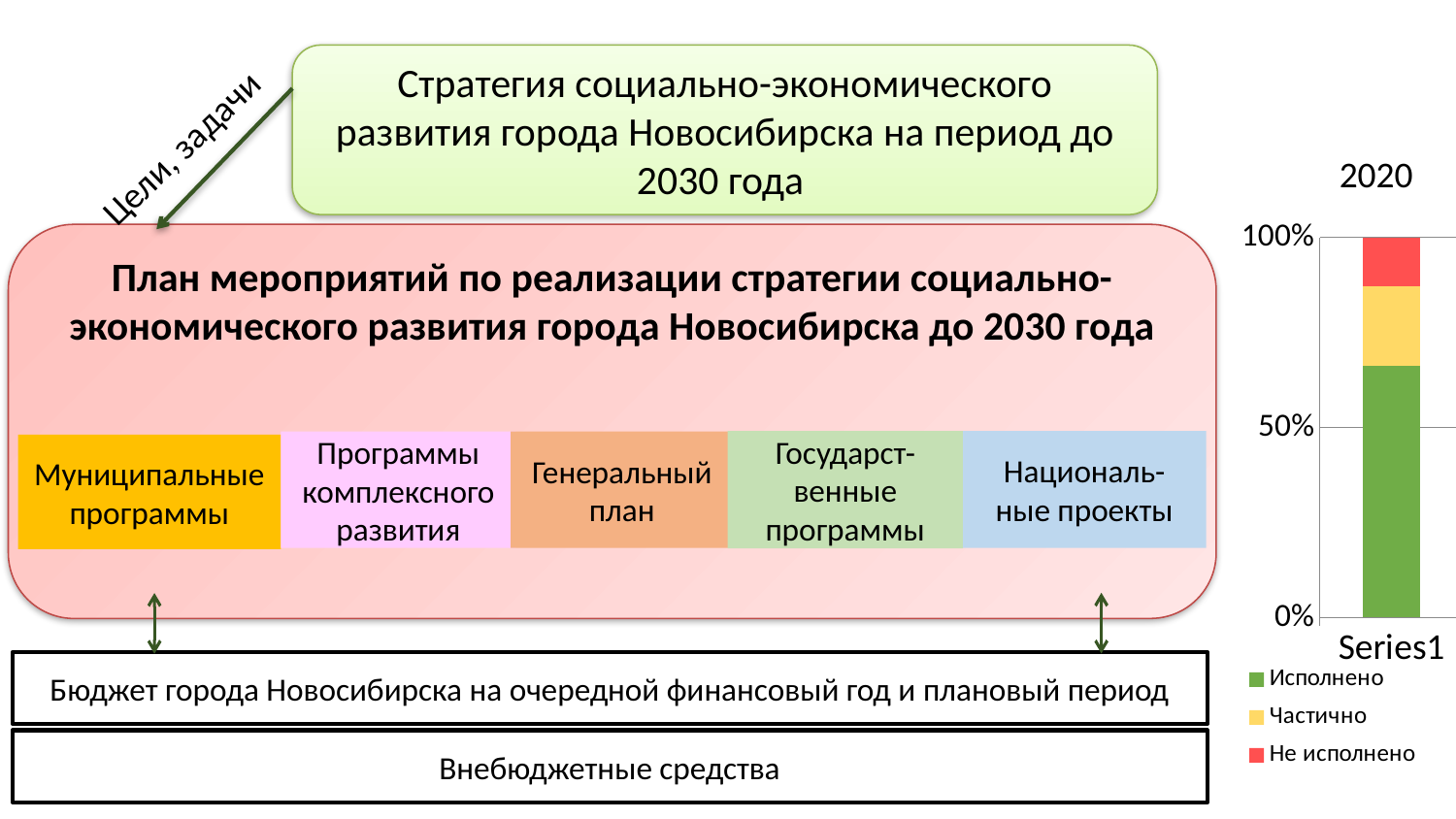
Is the value for Не исполнено in the chart greater or less than 50%? less Which series occupies the largest portion of the stacked bar in the chart? Исполнено What is the title of the chart on the right side of the slide? 2020 What is the highest value shown on the y axis of the chart? 100% Is the value for Исполнено in the chart greater or less than 50%? greater Which series occupies the smallest portion of the stacked bar in the chart? Не исполнено Which is larger in the chart, the Исполнено portion or the Частично portion? Исполнено What is the category label shown on the x axis of the chart? Series1 How many series does the legend of the chart list? 3 How many bars (categories) are plotted in the chart? 1 What is the total height of the stacked bar for Series1 in the chart? 100% What kind of chart is shown on the right side of the slide? stacked bar chart